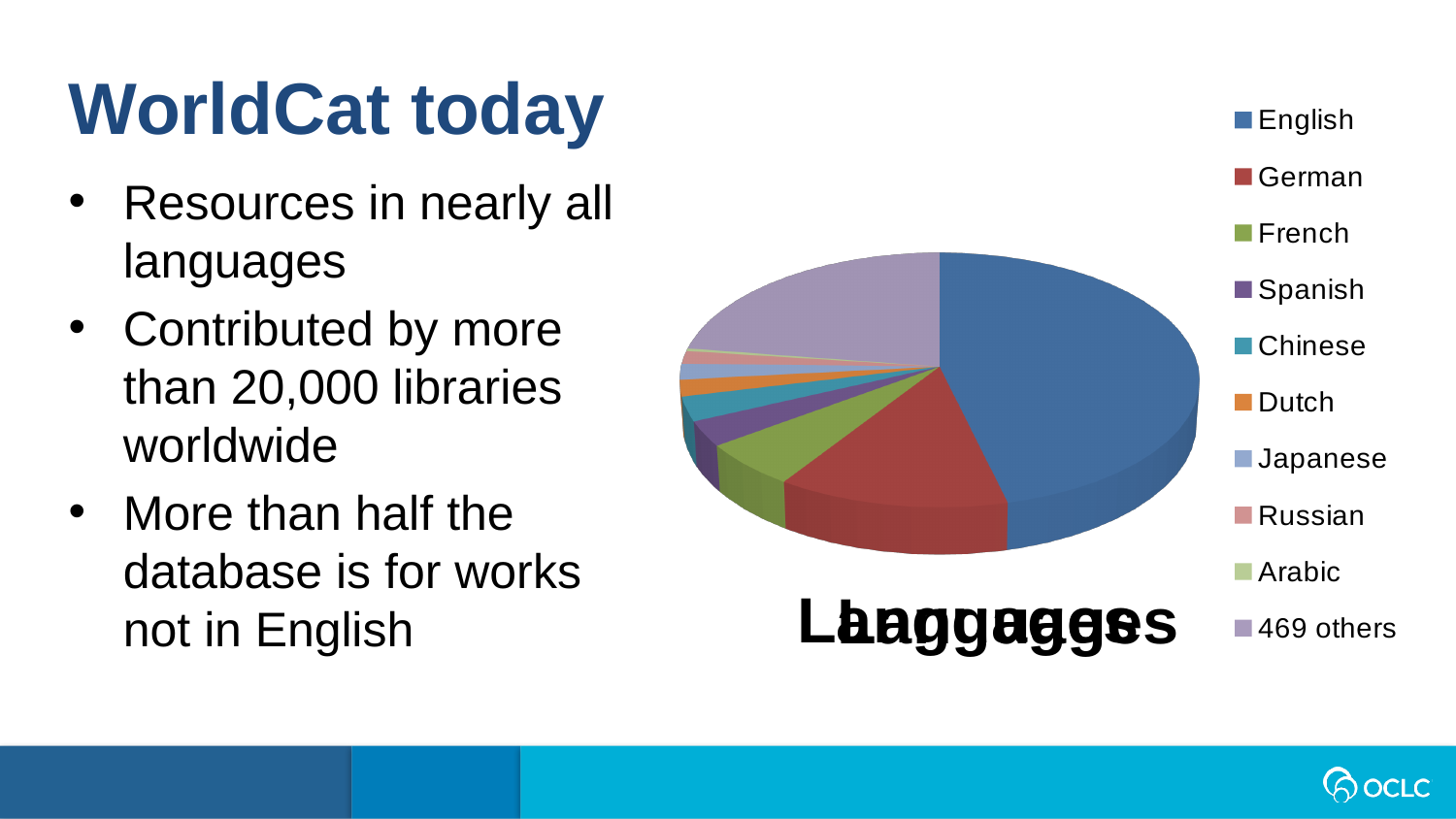
How many categories does the legend of the pie chart list? 10 Which slice is larger in the pie chart, German or French? German Which slice is larger in the pie chart, English or German? English Which slice is larger in the pie chart, 469 others or Chinese? 469 others What colour is the English slice in the pie chart? blue Which category is listed last in the pie chart's legend? 469 others What kind of chart is shown on the slide? pie chart Which language has the largest slice of the pie chart? English